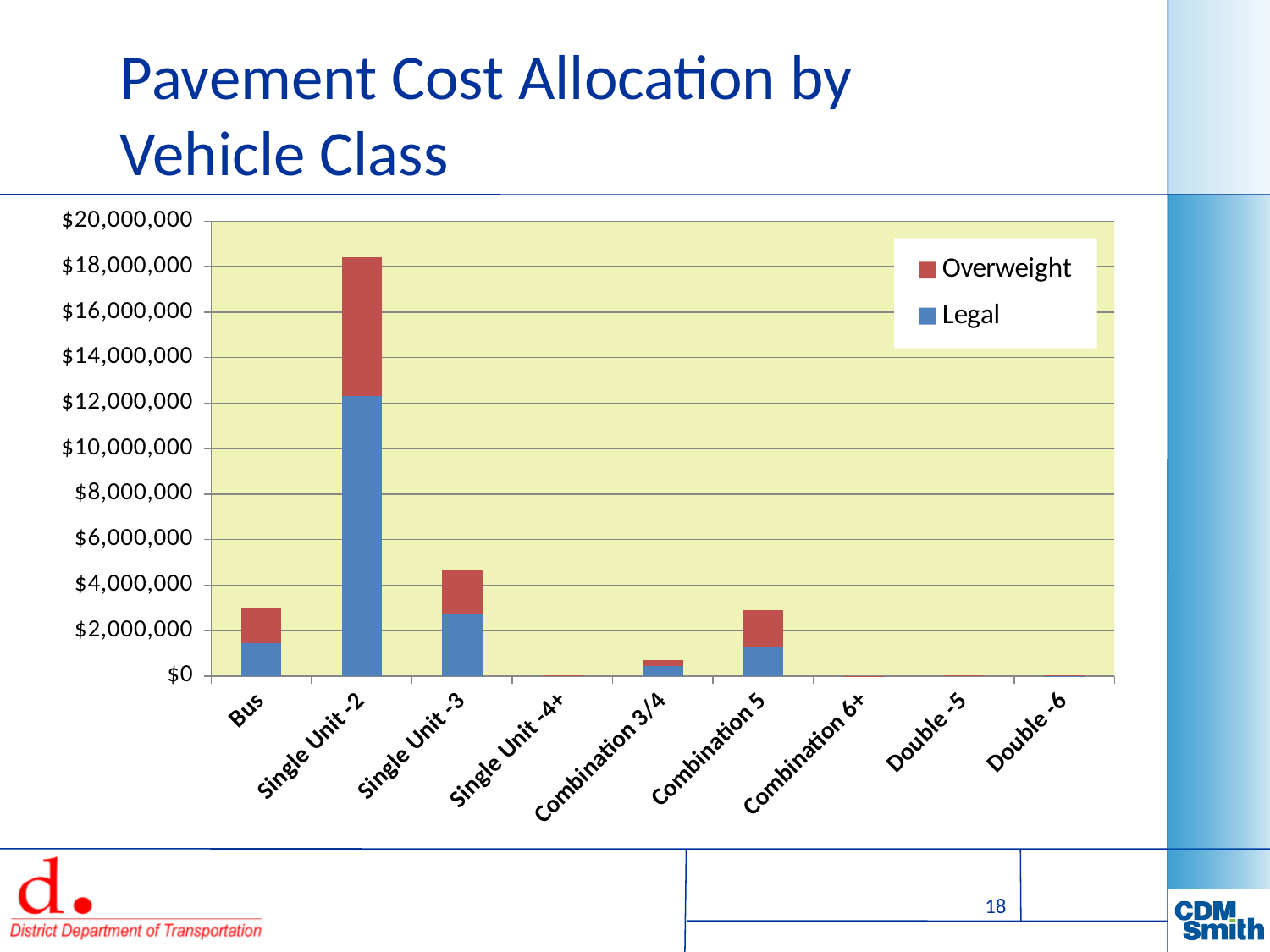
Which has a larger total pavement cost allocation, Single Unit -3 or Combination 5? Single Unit -3 Is the Legal portion for Single Unit -2 greater or less than $10,000,000? greater Is the total value for Single Unit -3 greater or less than $6,000,000? less Which vehicle class has the highest total pavement cost allocation? Single Unit -2 What kind of chart is shown on the slide? Stacked bar chart Which series is shown in red in the legend? Overweight What is the title of the chart on the slide? Pavement Cost Allocation by Vehicle Class Is the total value for Bus greater or less than $2,000,000? greater Which has a larger total pavement cost allocation, Bus or Combination 3/4? Bus How many vehicle class categories are shown on the x axis? 9 How many series does the legend list? 2